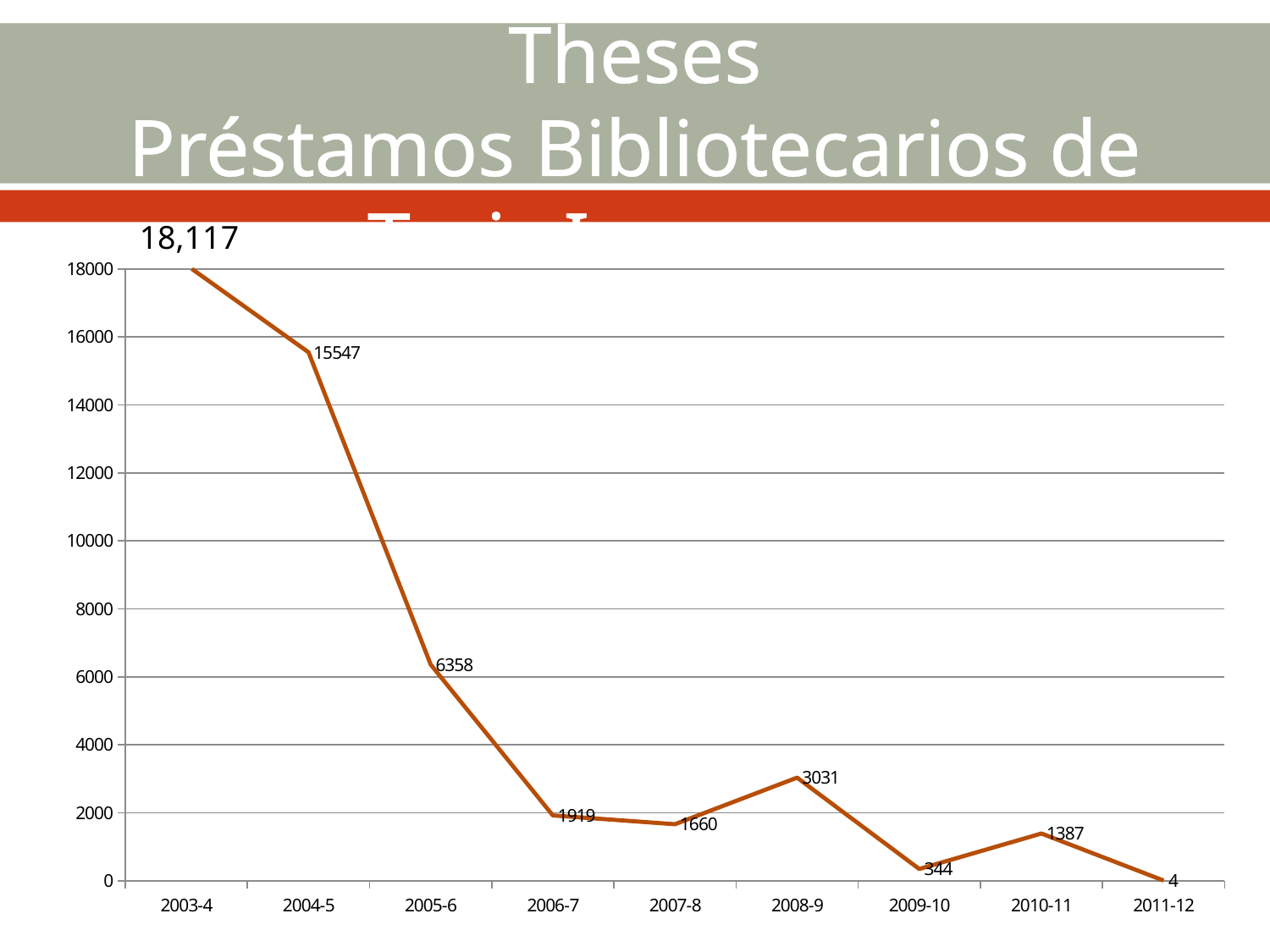
What is the value for 2008-9? 3031 Do the values generally rise or fall from 2003-4 to 2011-12? fall How many years are plotted on the x axis? 9 What kind of chart is shown? line chart Which year has the highest value? 2003-4 Which year has the lowest value? 2011-12 Which is larger, the value for 2008-9 or the value for 2010-11? 2008-9 What is the value for 2005-6? 6358 Is the value for 2006-7 greater or less than 4000? less What is the difference between the values for 2004-5 and 2005-6? 9189 What is the value for 2011-12? 4 What is the value for 2004-5? 15547